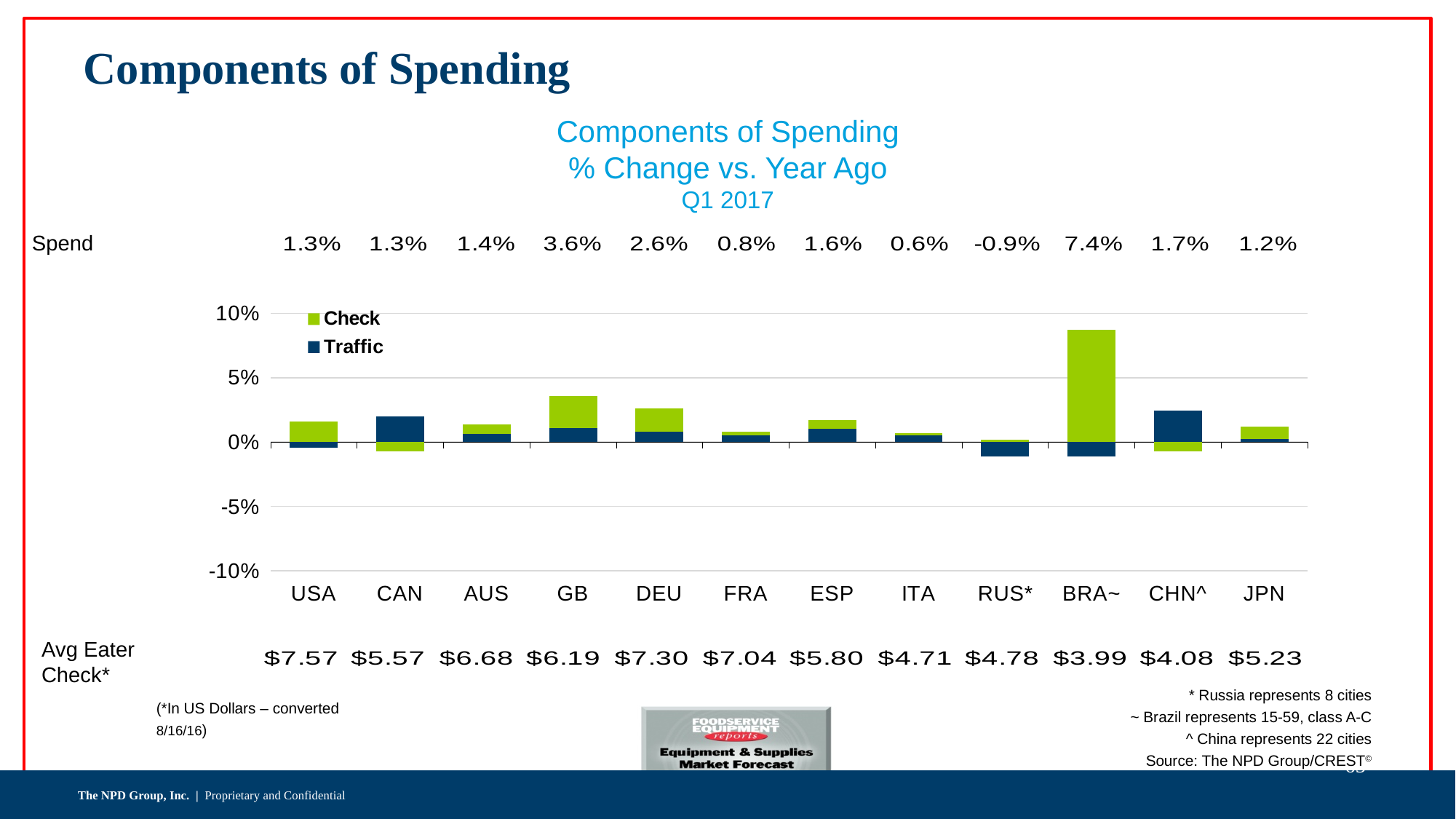
Is the Check bar for BRA~ greater or less than 5%? greater How many countries are shown along the x axis of the chart? 12 Which country has the lowest Spend % change? RUS* What is the Spend % change for RUS*? -0.9% What is the Spend % change for GB? 3.6% What kind of chart is shown on the slide? bar chart Which country has the lowest Avg Eater Check? BRA~ What is the difference between the Spend % change for GB and DEU? 1.0% What is the Avg Eater Check for USA? $7.57 How many series does the chart legend list? 2 Which colour represents the Traffic series in the chart? dark blue Which country has the highest Spend % change? BRA~